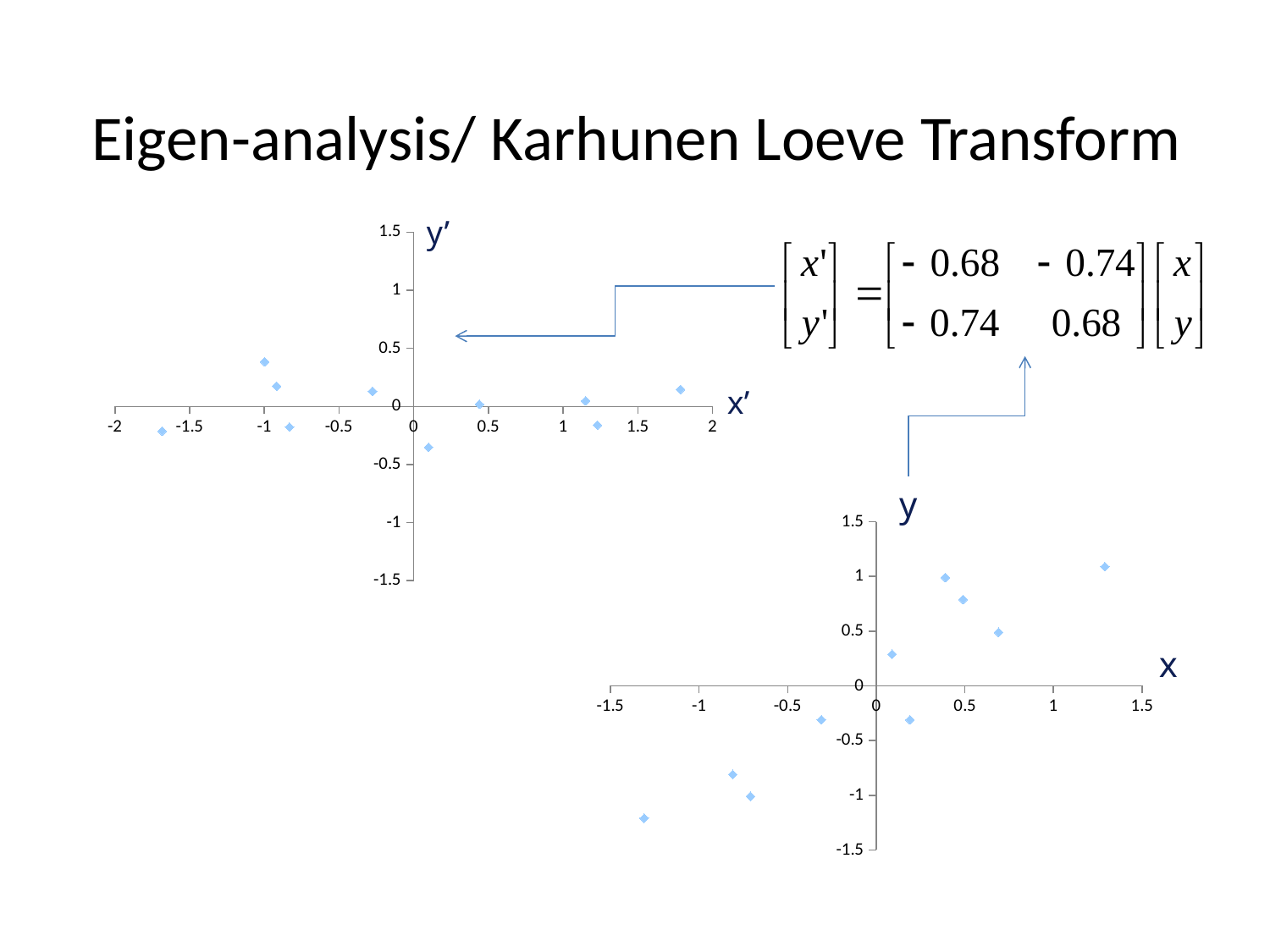
In the lower-right chart (x, y), is the point with the highest y value located at an x value greater or less than 1? greater What kind of chart is the chart on the left of the slide (with axes x' and y')? scatter chart In the lower-right chart (x, y), do the y values generally rise or fall as x increases? rise What is the minimum value shown on the x axis of the lower-right chart? -1.5 How many data points are plotted in the lower-right chart (x, y)? 10 In the lower-right chart (x, y), is the y value of the rightmost point greater or less than 1? greater What is the maximum value shown on the x' axis of the left chart? 2 What kind of chart is the chart on the lower right of the slide (with axes x and y)? scatter chart In the left chart (x', y'), is the x' value of the leftmost point greater or less than -1.5? less